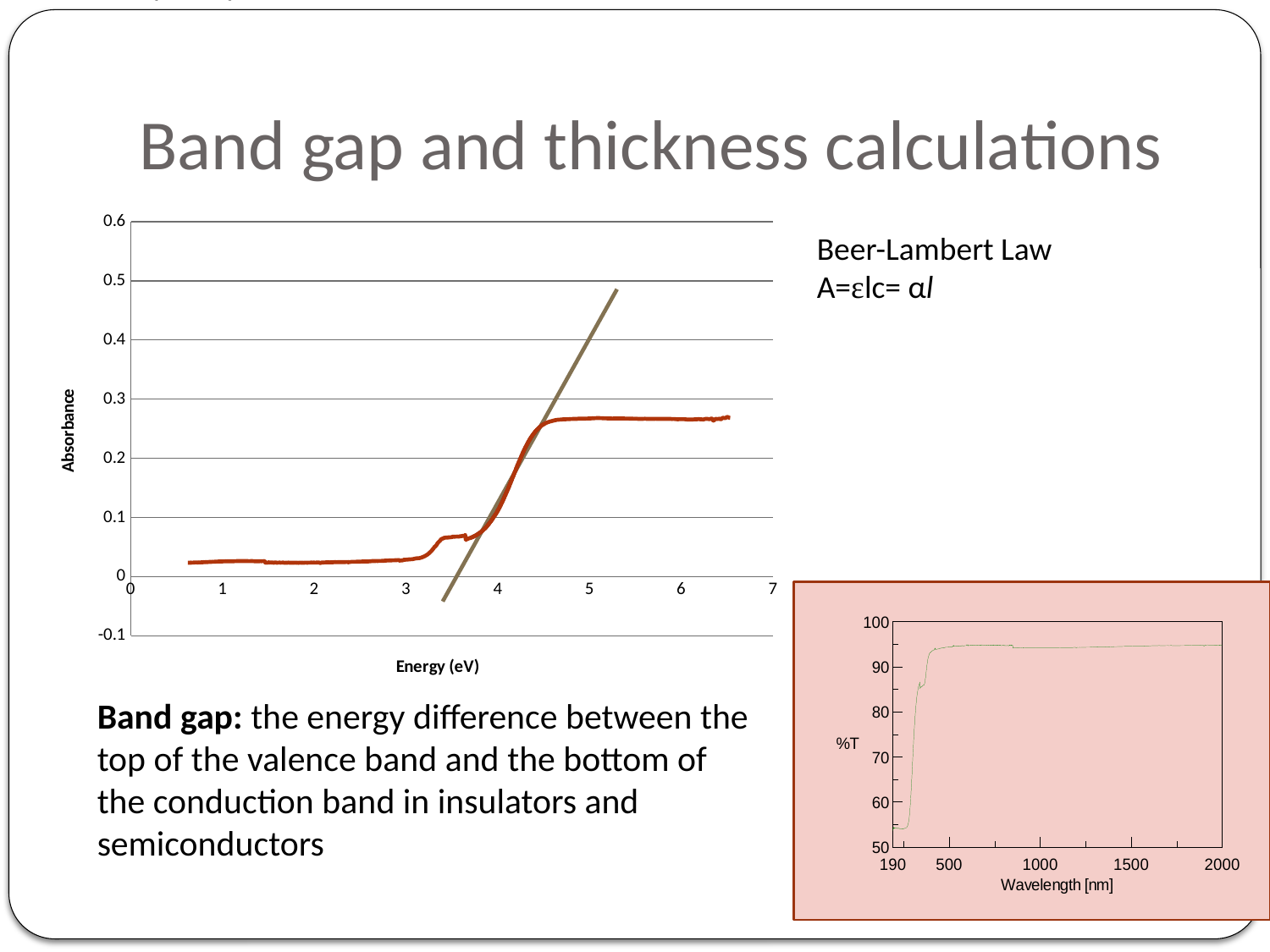
What type of chart is the small chart in the pink box at the bottom right? line chart How many charts are shown on the slide? 2 In the left chart, what is the label of the y axis? Absorbance In the bottom-right chart, is the %T at 190 nm greater or less than 60? less In the left chart, is the absorbance at 2 eV greater or less than 0.1? less In the bottom-right chart, does %T rise or fall as wavelength increases from 190 nm to 500 nm? rise In the left chart, is the absorbance at 6 eV greater or less than 0.2? greater In the left chart, what is the highest value shown on the y axis? 0.6 In the left chart, what is the label of the x axis? Energy (eV) What type of chart is the large chart on the left of the slide? line chart In the left chart, does the absorbance overall rise or fall as energy increases from 1 eV to 5 eV? rise